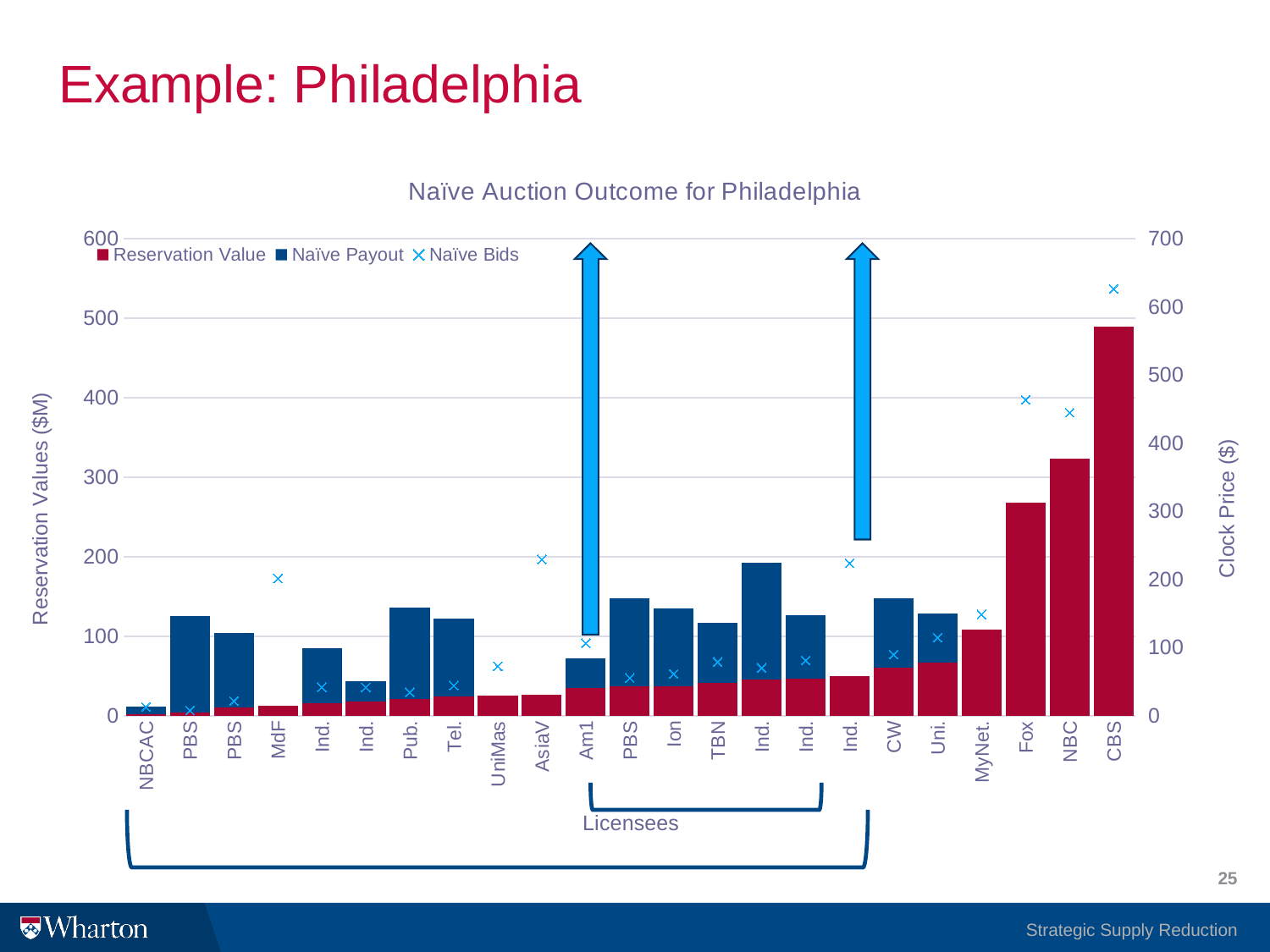
How many series does the chart legend list? 3 Is the Reservation Value for Fox greater or less than 200? greater Which has the larger Reservation Value, Fox or NBC? NBC How many licensee categories are shown along the x axis? 23 What kind of chart is shown on the slide? bar chart Which category has the highest Reservation Value? CBS What is the title of the chart? Naïve Auction Outcome for Philadelphia Is the Reservation Value for CBS greater or less than 400? greater What is the title of the right-hand vertical axis? Clock Price ($) Is the Reservation Value for NBC greater or less than 400? less